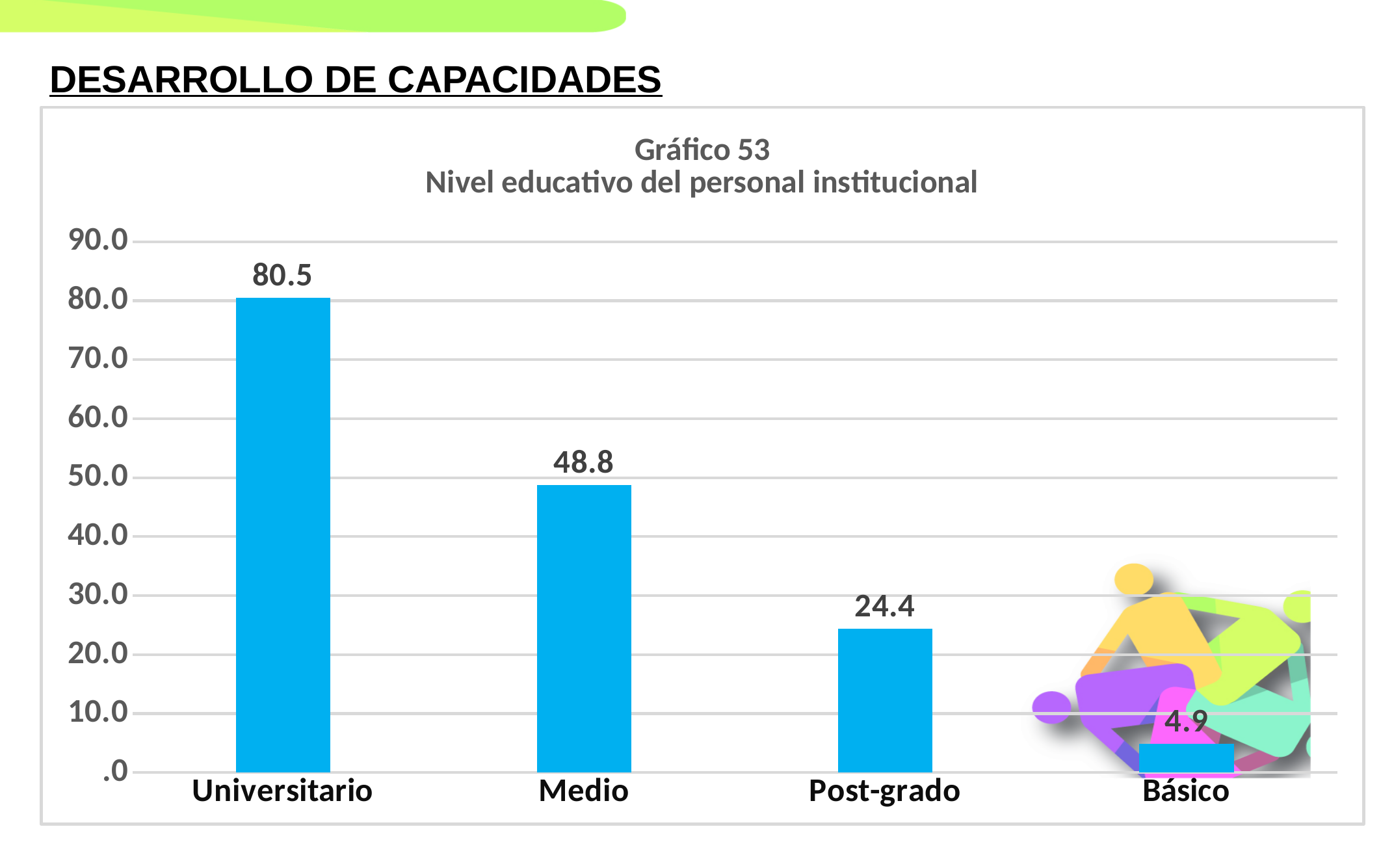
What is the title of the chart? Gráfico 53 Nivel educativo del personal institucional What is the value for Post-grado? 24.4 Which is larger, the value for Medio or the value for Post-grado? Medio What kind of chart is shown on the slide? Bar chart What is the value for Básico? 4.9 How many categories are shown on the x axis? 4 What is the difference between the values for Post-grado and Básico? 19.5 Which category has the lowest value? Básico What is the value for Universitario? 80.5 What is the value for Medio? 48.8 What is the difference between the values for Universitario and Medio? 31.7 Which category has the highest value? Universitario